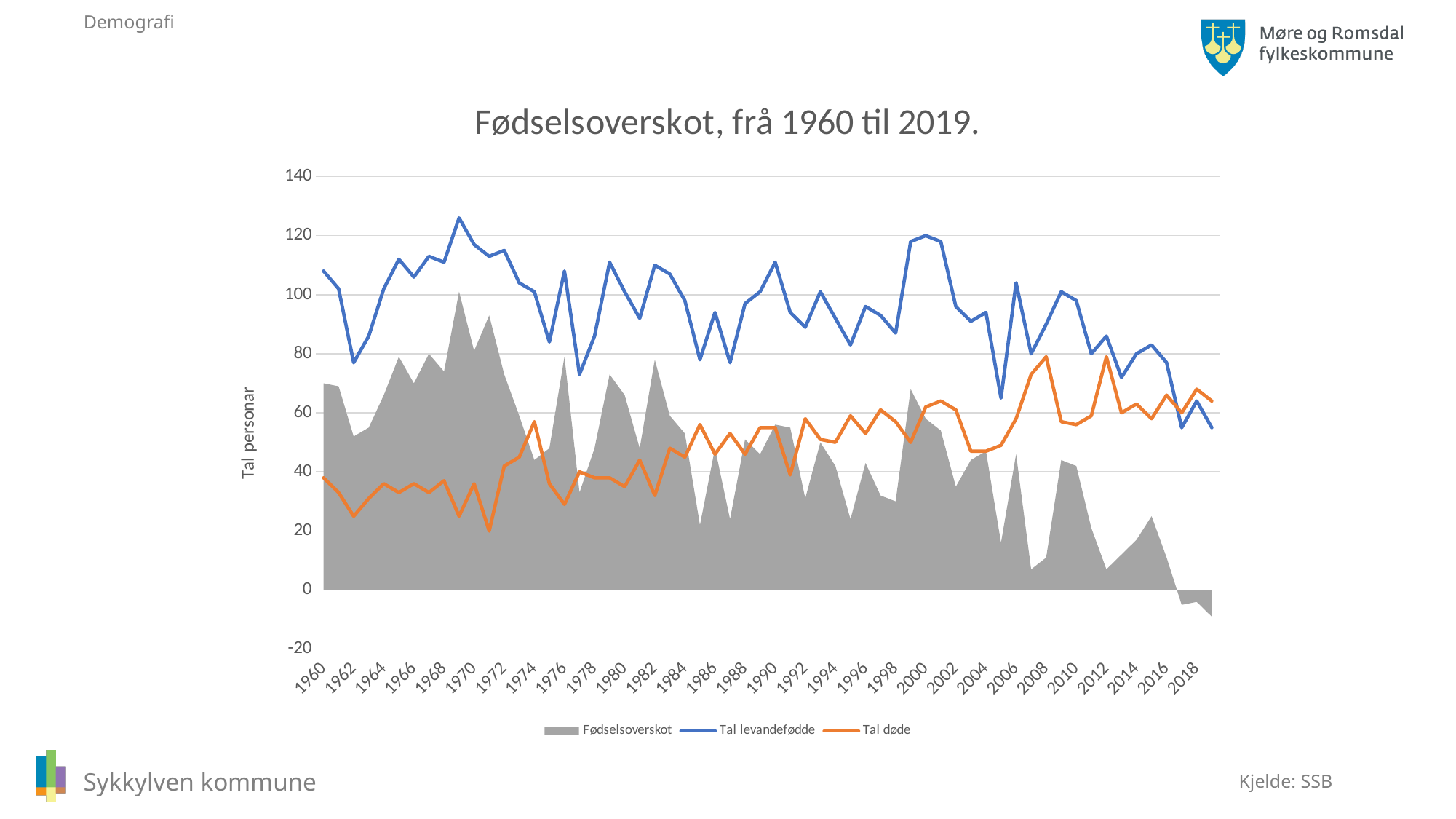
In 1960, which is larger: Tal levandefødde or Tal døde? Tal levandefødde Is the value for Fødselsoverskot in 2019 greater or less than 0? less Does the Tal døde series generally rise or fall from 1960 to 2019? rise Is the value for Tal levandefødde in 1969 greater or less than 120? greater In 2019, which is larger: Tal levandefødde or Tal døde? Tal døde What is the label on the vertical axis? Tal personar What is the title of the chart? Fødselsoverskot, frå 1960 til 2019. How many series does the legend list? 3 Is the value for Tal levandefødde in 1960 greater or less than 100? greater Does the Fødselsoverskot series generally rise or fall from 1960 to 2019? fall